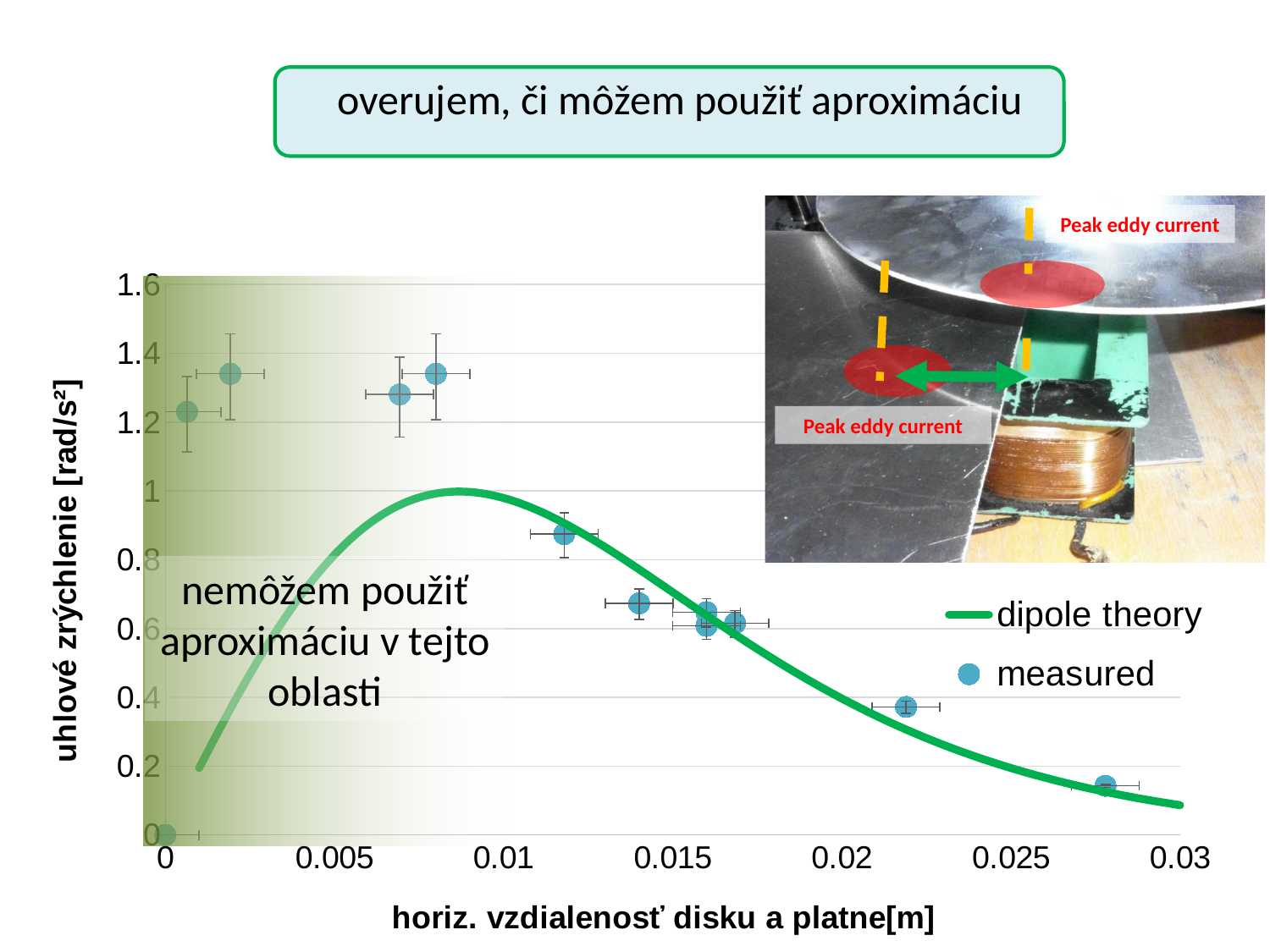
What are the two entries in the chart legend? dipole theory, measured How does the dipole theory curve behave as the horizontal distance increases from 0.01 m to 0.03 m? it falls Is the measured value at a horizontal distance of about 0.028 m greater or less than 0.2? less What is the label of the chart's x axis? horiz. vzdialenosť disku a platne[m] Is the dipole theory value at a horizontal distance of 0.03 m greater or less than 0.2? less At which horizontal distance is the lowest measured value plotted? 0 Is the measured value at a horizontal distance of 0.002 m greater or less than 1.2? greater How many series does the chart legend list? 2 Which is larger: the measured value at 0.002 m or the measured value at about 0.022 m? 0.002 m What kind of chart is shown on the slide? scatter chart with a line